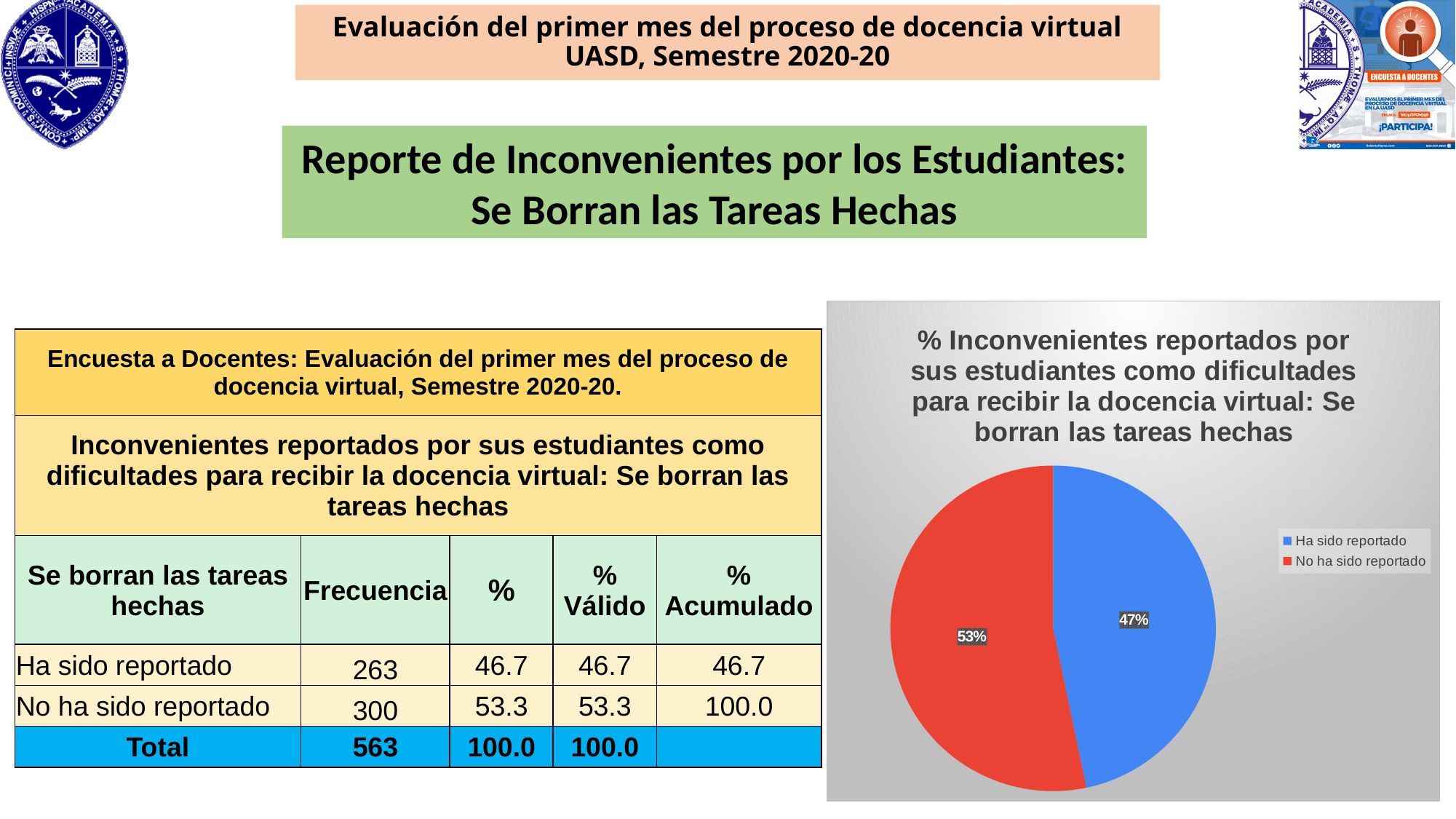
How many entries does the pie chart's legend list? 2 Which slice of the pie chart is the smallest? Ha sido reportado How many slices does the pie chart have? 2 Which is larger in the pie chart: "Ha sido reportado" or "No ha sido reportado"? No ha sido reportado What is the title of the pie chart? % Inconvenientes reportados por sus estudiantes como dificultades para recibir la docencia virtual: Se borran las tareas hechas What kind of chart is shown on the slide? pie chart What percentage does the pie chart show for "No ha sido reportado"? 53% What percentage does the pie chart show for "Ha sido reportado"? 47% What colour is the "No ha sido reportado" slice in the pie chart? red What share of the pie does the blue slice represent? 47% By how many percentage points does "No ha sido reportado" exceed "Ha sido reportado" in the pie chart? 6 Which slice of the pie chart is the largest? No ha sido reportado